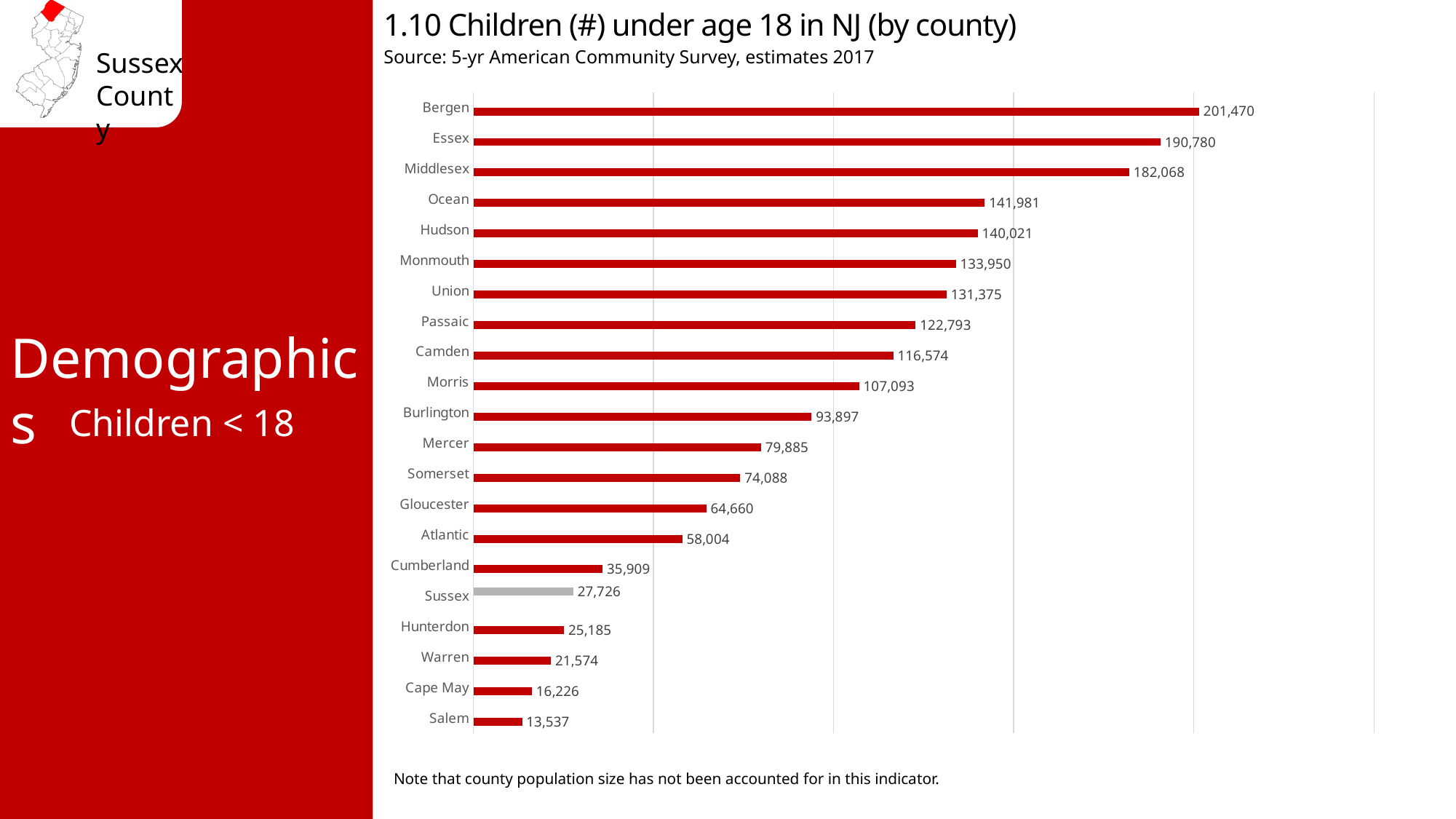
How many children under 18 are shown for Morris County? 107,093 Which county has more children under 18, Camden or Passaic? Passaic Which county has the lowest number of children under age 18? Salem What is the value shown for Ocean County? 141,981 What type of chart is used on this slide? Bar chart What is the difference between the values for Sussex and Hunterdon? 2,541 How many counties are shown in the chart? 21 Which county's bar is shown in a different colour (grey) from the others? Sussex Which county has the highest number of children under age 18? Bergen Which has the larger value, Warren or Cape May? Warren What is the number of children under age 18 in Sussex County? 27,726 What is the difference between the values for Bergen and Essex? 10,690